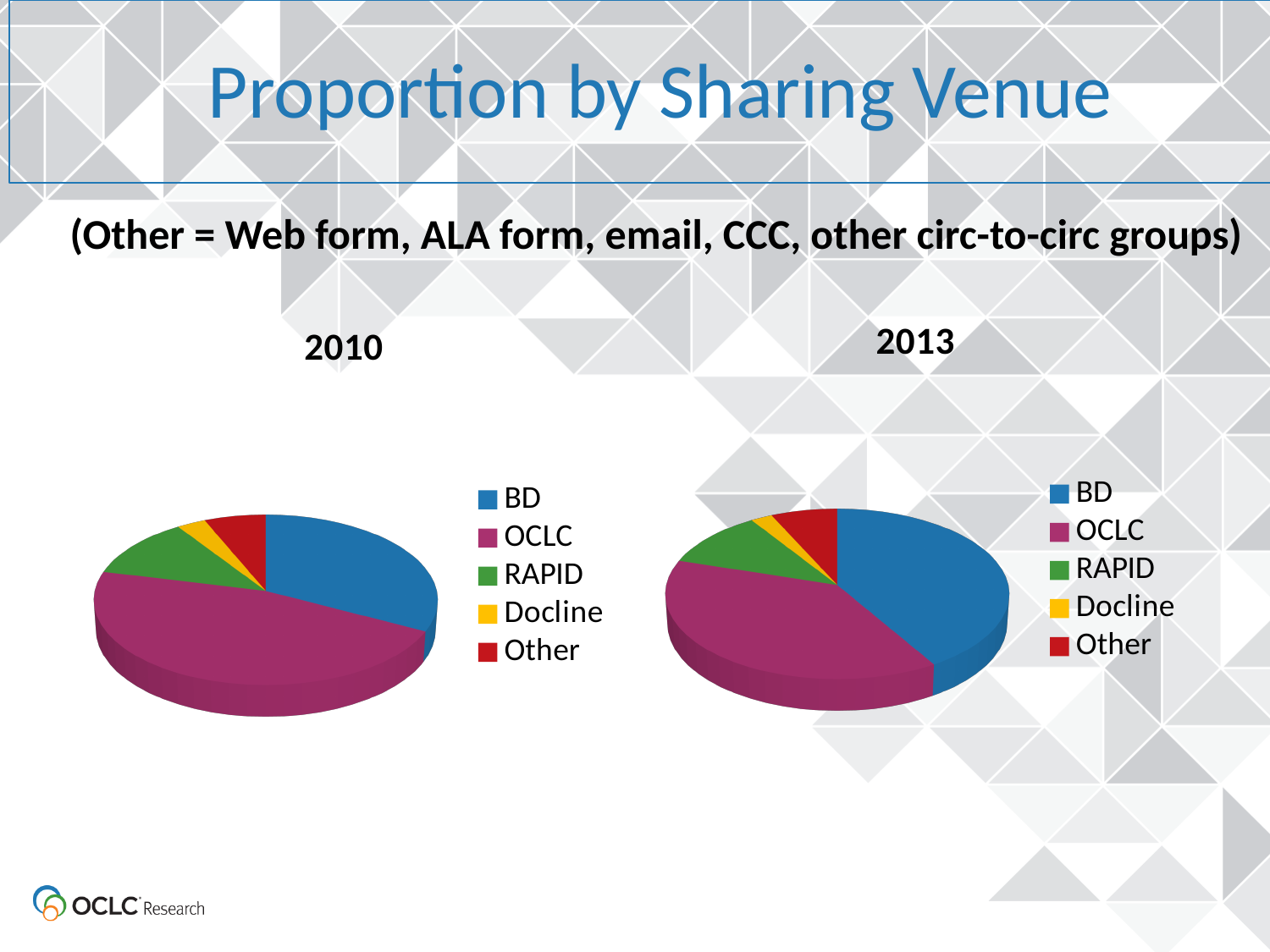
In the 2013 chart, which sharing venue has the largest slice? BD In the 2013 chart, which slice is larger, Other or Docline? Other How many entries does the legend of the 2013 chart list? 5 What colour represents RAPID in the legend of the 2010 chart? green In the 2010 chart, which slice is larger, BD or RAPID? BD In the 2010 chart, which sharing venue has the smallest slice? Docline In the 2013 chart, which slice is larger, OCLC or BD? BD In the 2010 chart, which sharing venue has the largest slice? OCLC What kind of chart is the 2010 chart? pie chart In the 2013 chart, which sharing venue has the smallest slice? Docline How many slices does the 2010 pie chart have? 5 What kind of chart is the 2013 chart? pie chart